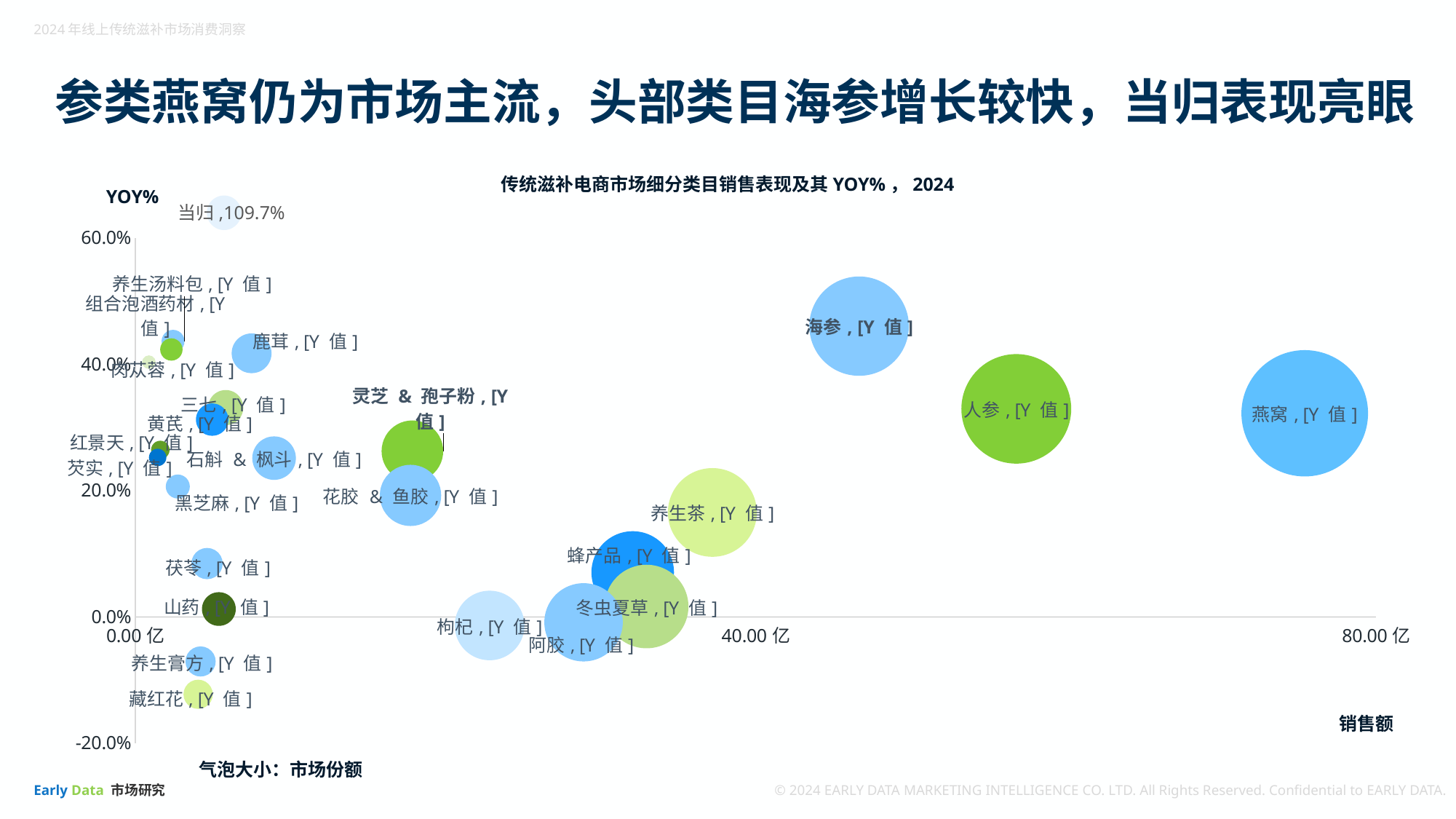
Is the 销售额 for 燕窝 greater or less than 40.00 亿? greater Which category has the highest 销售额 (furthest right on the x axis)? 燕窝 Which category has the lowest YOY%? 藏红花 Which has the higher YOY%, 海参 or 人参? 海参 Is the YOY% for 养生茶 greater or less than 20.0%? less Is the YOY% for 藏红花 greater or less than 0.0%? less What is the YOY% value printed for 当归? 109.7% What kind of chart is shown on the slide? bubble chart Which category has the highest YOY%? 当归 According to the note below the chart, what does the bubble size represent? 市场份额 Which has the larger 销售额, 燕窝 or 人参? 燕窝